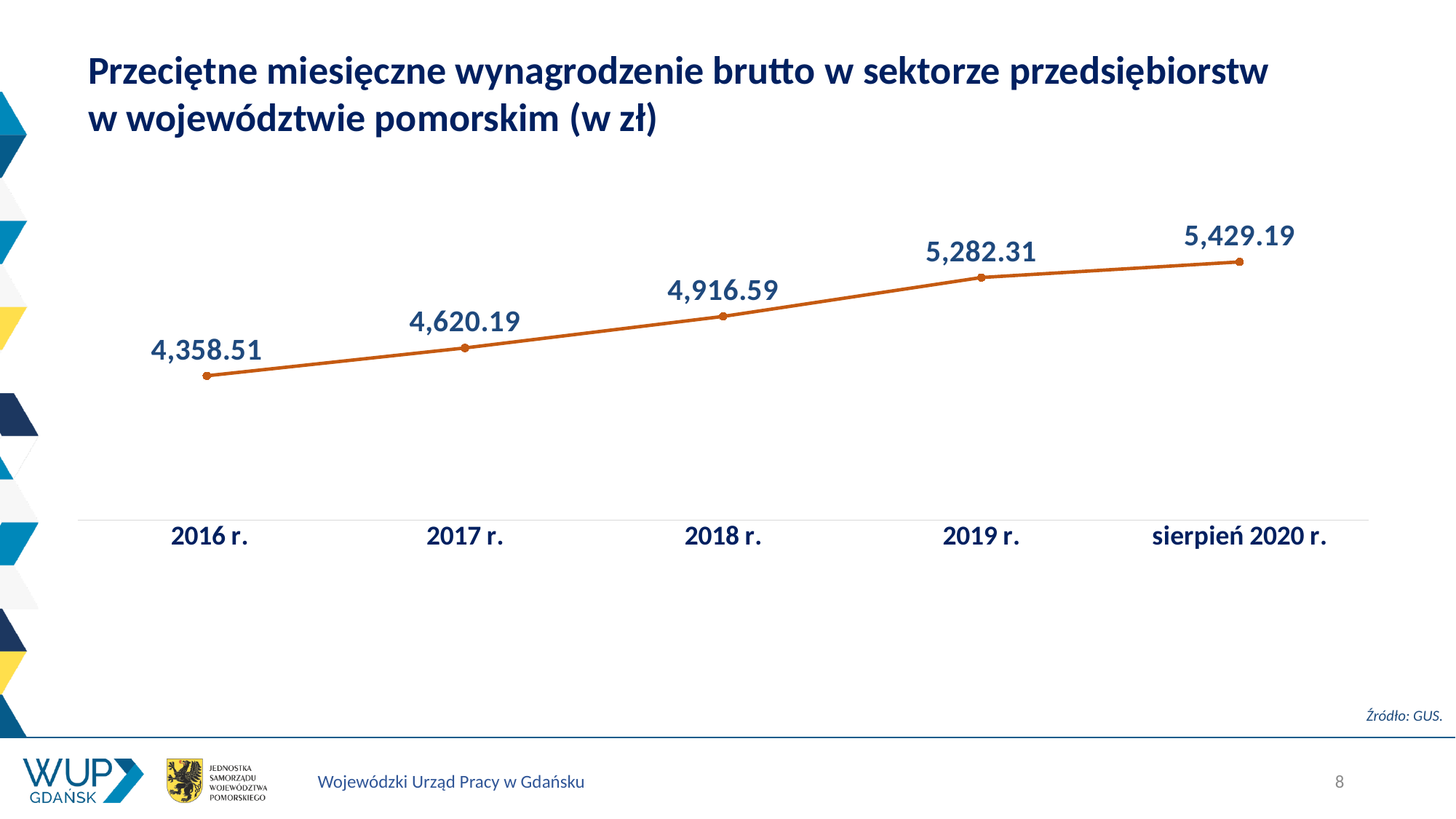
Which period has the lowest value on the chart? 2016 r. What value is shown for 2019 r.? 5,282.31 What value is shown for 2018 r.? 4,916.59 What was the average monthly gross wage in 2016 r.? 4,358.51 What value is shown for sierpień 2020 r.? 5,429.19 How many data points are plotted on the chart? 5 Which is larger, the value for 2018 r. or the value for 2019 r.? 2019 r. What is the difference between the values for sierpień 2020 r. and 2019 r.? 146.88 Do the values rise or fall from 2016 r. to sierpień 2020 r.? rise What type of chart is shown on the slide? line chart Which period has the highest value on the chart? sierpień 2020 r. What is the difference between the values for 2017 r. and 2016 r.? 261.68